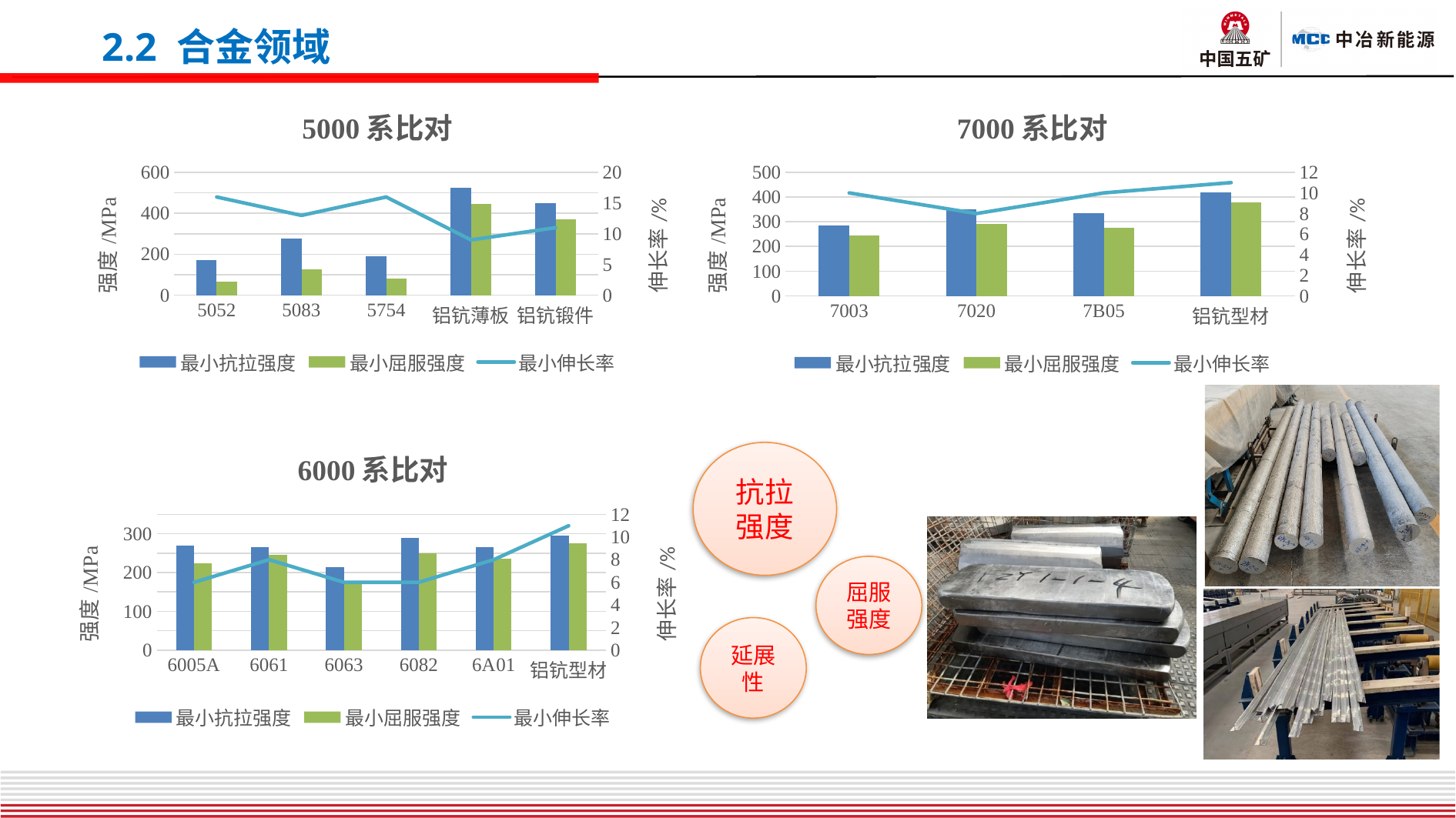
In the chart titled 6000 系比对, which category has the highest 最小伸长率? 铝钪型材 In the chart titled 7000 系比对, which category has the lowest 最小抗拉强度? 7003 In the chart titled 6000 系比对, which category has the lowest 最小抗拉强度? 6063 In the chart titled 5000 系比对, which is larger, the 最小抗拉强度 for 铝钪薄板 or for 铝钪锻件? 铝钪薄板 How many categories are shown on the x axis of the chart titled 6000 系比对? 6 How many categories are shown on the x axis of the chart titled 5000 系比对? 5 In the chart titled 7000 系比对, which is larger, the 最小抗拉强度 for 7020 or for 7003? 7020 In the chart titled 5000 系比对, is the 最小抗拉强度 for 5052 greater or less than 200? less In the chart titled 7000 系比对, is the 最小屈服强度 for 铝钪型材 greater or less than 300? greater In the chart titled 5000 系比对, is the 最小抗拉强度 for 铝钪薄板 greater or less than 400? greater How many series does the legend of the chart titled 7000 系比对 list? 3 In the chart titled 5000 系比对, which category has the highest 最小抗拉强度? 铝钪薄板